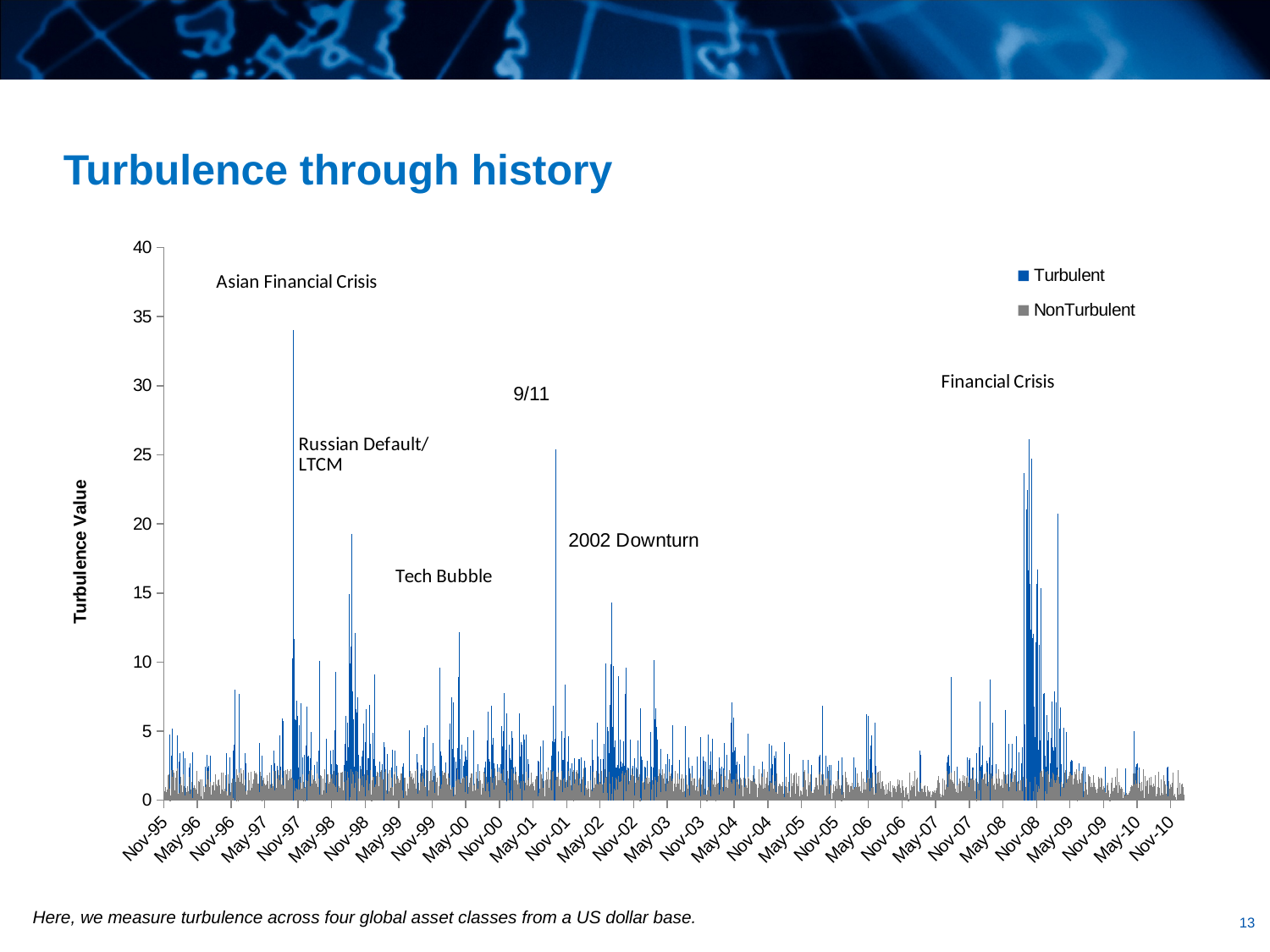
How many series does the legend list? 2 Is the peak turbulence value at the 2002 Downturn greater or less than 20? less What kind of chart is shown on the slide? Bar chart What are the two series named in the legend? Turbulent and NonTurbulent What is the highest tick value shown on the vertical axis? 40 Is the peak turbulence value during the Tech Bubble greater or less than 15? less Is the peak turbulence value at 9/11 greater or less than 20? greater What is the label on the vertical axis? Turbulence Value Which has a higher peak turbulence value: the Asian Financial Crisis or 9/11? Asian Financial Crisis Which annotated event has the highest turbulence value on the chart? Asian Financial Crisis